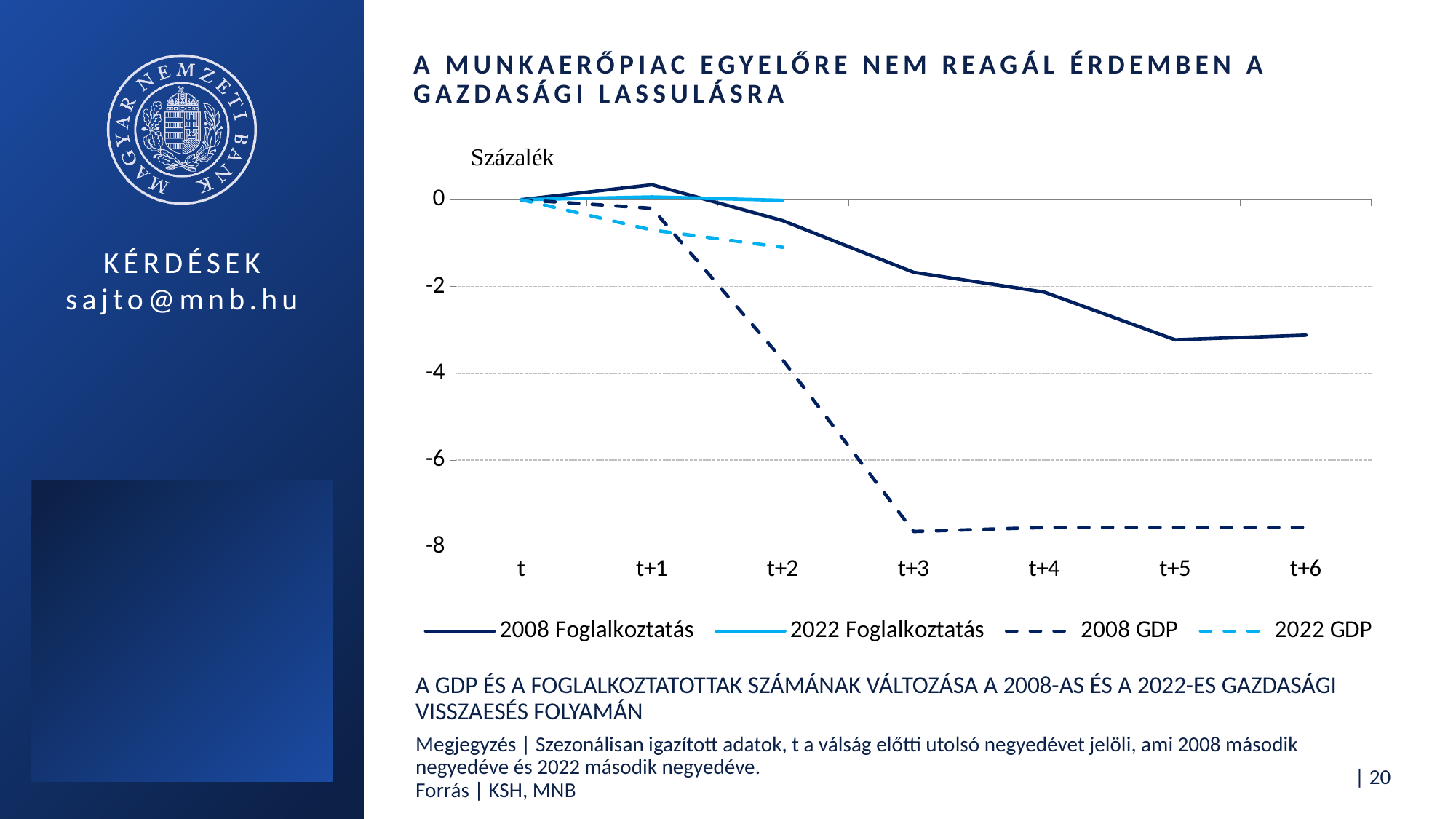
Which series reaches the lowest value on the chart? 2008 GDP At t+2, which series has the higher value, 2008 GDP or 2022 GDP? 2022 GDP Up to which x-axis point do the 2022 series extend? t+2 Is the value for 2008 Foglalkoztatás at t+5 greater or less than -2? less Does the 2008 GDP line rise or fall from t to t+3? fall What unit label is shown above the y axis? Százalék How many series does the legend list? 4 Is the value for 2008 Foglalkoztatás at t+3 greater or less than -4? greater How many time points are labelled on the x axis? 7 Is the value for 2008 GDP at t+3 greater or less than -6? less What type of chart is shown on the slide? line chart